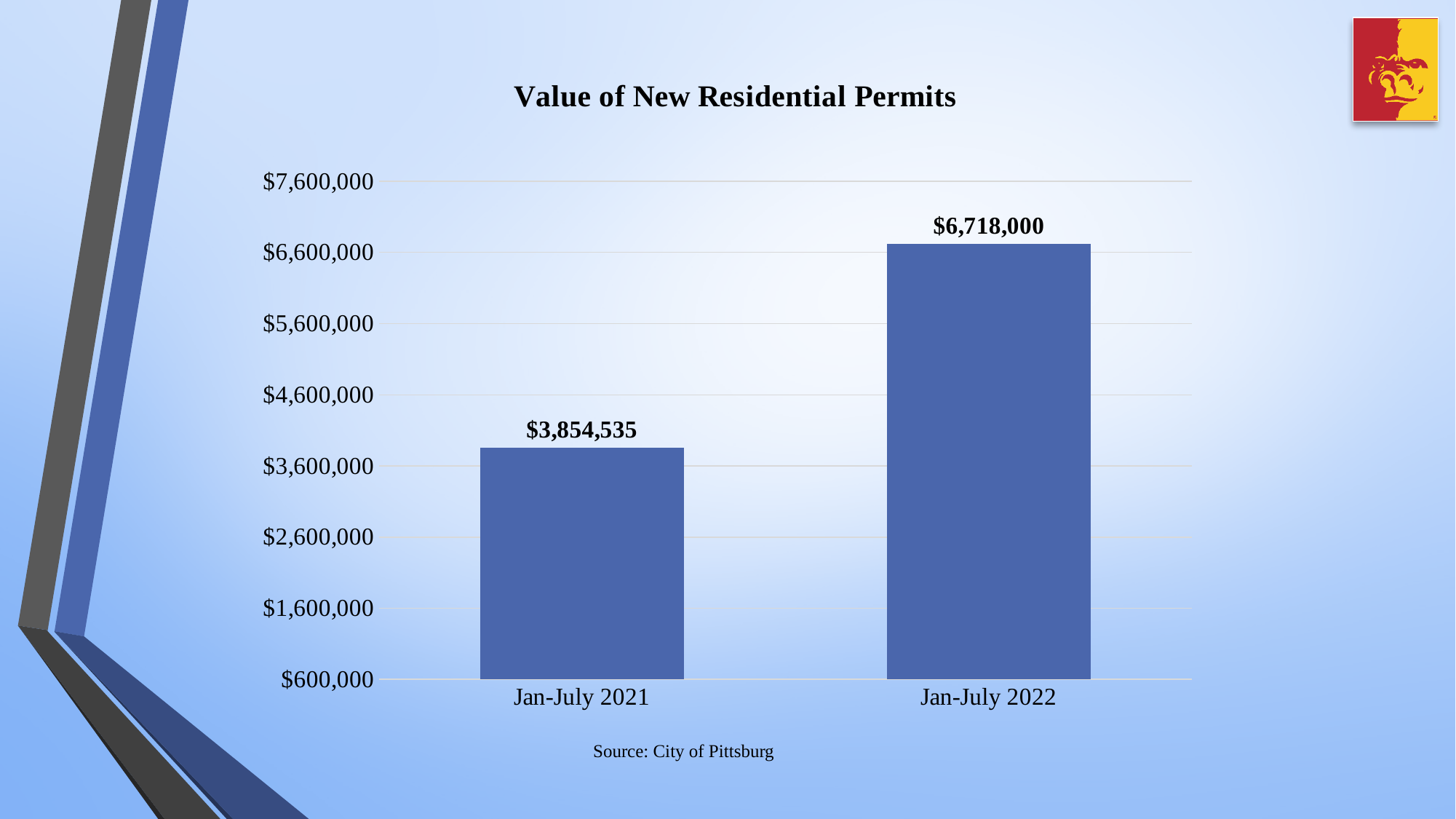
What kind of chart is shown on the slide? Bar chart Do the values rise or fall from Jan-July 2021 to Jan-July 2022? Rise How many periods are shown on the chart? 2 Is the value for Jan-July 2022 greater or less than $5,600,000? greater What is the value of new residential permits for Jan-July 2021? $3,854,535 Which period has the higher value of new residential permits? Jan-July 2022 What is the title of the chart? Value of New Residential Permits What source is cited below the chart? City of Pittsburg What is the difference in value between Jan-July 2022 and Jan-July 2021? $2,863,465 Which period has the lower value of new residential permits? Jan-July 2021 Is the value for Jan-July 2021 greater or less than $4,600,000? less What is the value of new residential permits for Jan-July 2022? $6,718,000